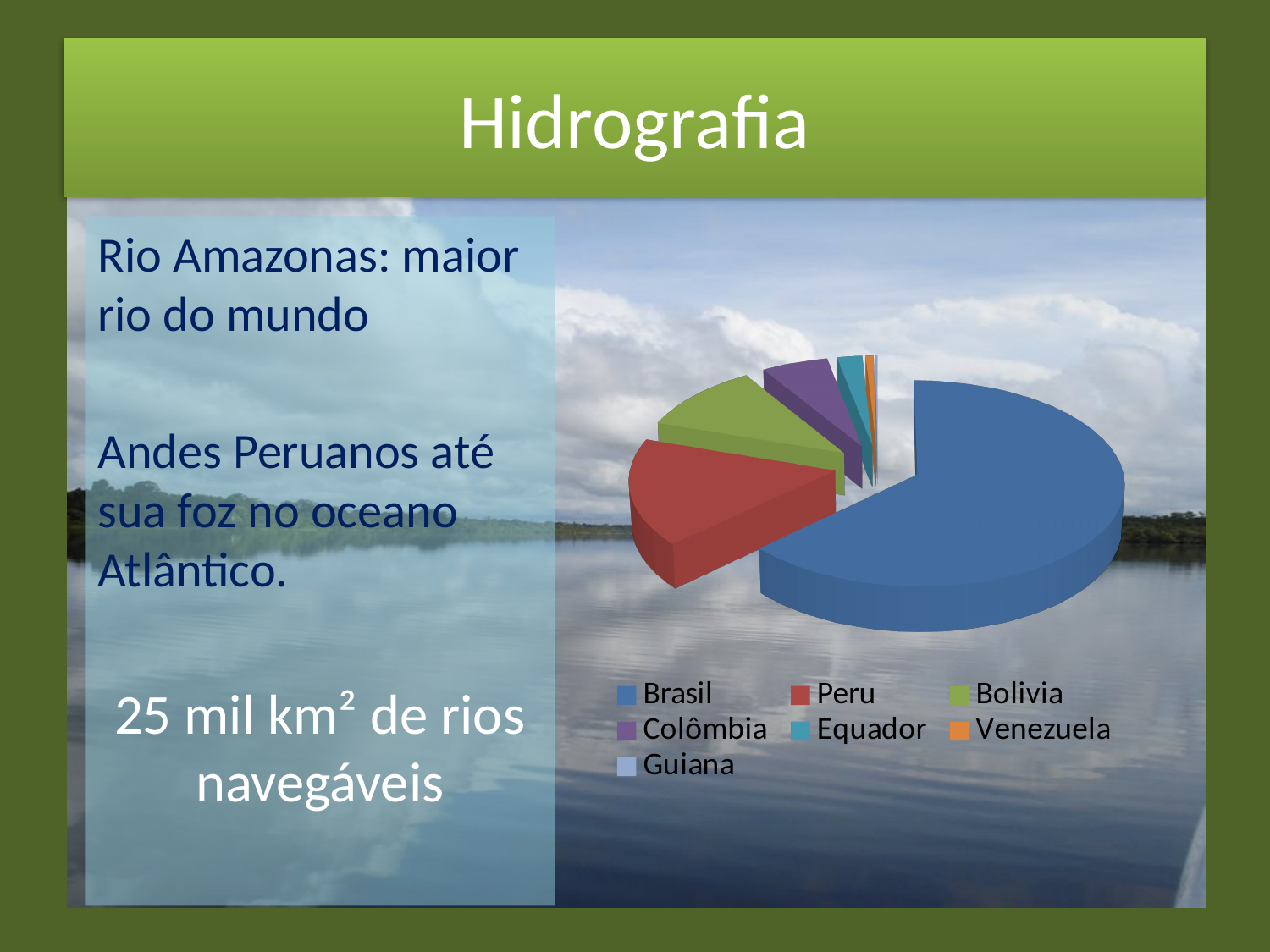
What kind of chart is shown on the slide? pie chart Which slice is larger in the pie chart, Peru or Venezuela? Peru What colour is the Brasil slice in the pie chart? blue Which category has the largest slice in the pie chart? Brasil Which slice is larger in the pie chart, Peru or Bolivia? Peru Which slice is larger in the pie chart, Bolivia or Colômbia? Bolivia How many categories does the pie chart's legend list? 7 Which category is shown in red in the pie chart's legend? Peru